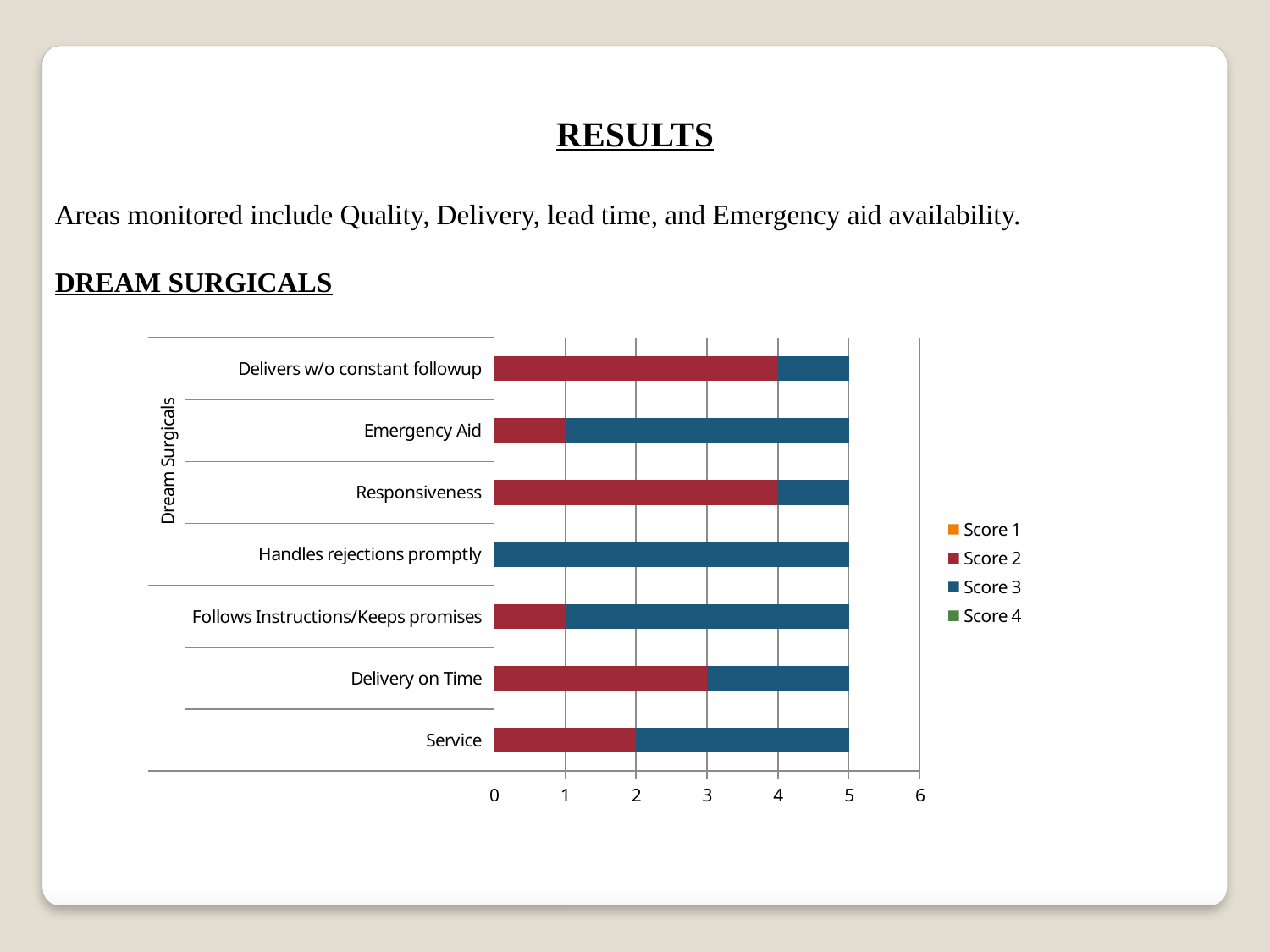
What is the label on the vertical axis of the chart? Dream Surgicals How many categories are shown on the chart? 7 How many series does the legend list? 4 What is the Score 2 value for Delivers w/o constant followup? 4 What is the difference between the Score 2 value for Delivers w/o constant followup and the Score 2 value for Emergency Aid? 3 What is the Score 3 value for Service? 3 Which is larger, the Score 2 value for Responsiveness or the Score 2 value for Service? Responsiveness What is the Score 3 value for Emergency Aid? 4 What is the Score 2 value for Delivery on Time? 3 Which category has the highest Score 3 value? Handles rejections promptly What kind of chart is shown on the slide? bar chart What is the total of the stacked bar for Handles rejections promptly? 5